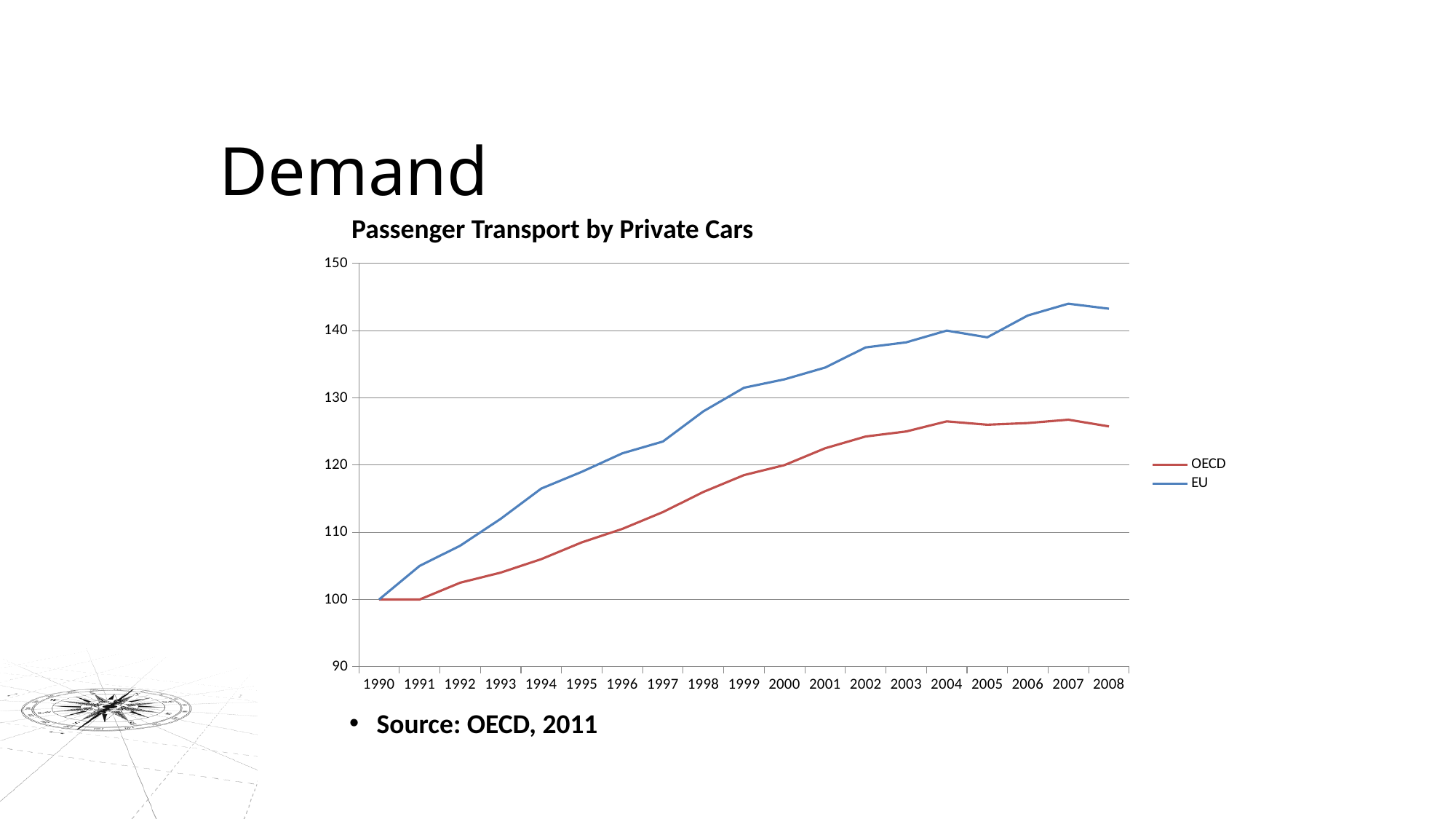
Is the value for EU in 2008 greater or less than 140? greater Do the EU values generally rise or fall from 1990 to 2008? rise Is the value for OECD in 2008 greater or less than 130? less How many series does the legend list? 2 What is the value for EU in 1990? 100 What is the value for OECD in 1990? 100 What kind of chart is shown on the slide? line chart Is the value for EU in 1999 greater or less than 130? greater What is the title of the chart? Passenger Transport by Private Cars Which series has the higher value in 2005, OECD or EU? EU Which series is drawn in blue? EU How many years are shown on the x axis? 19